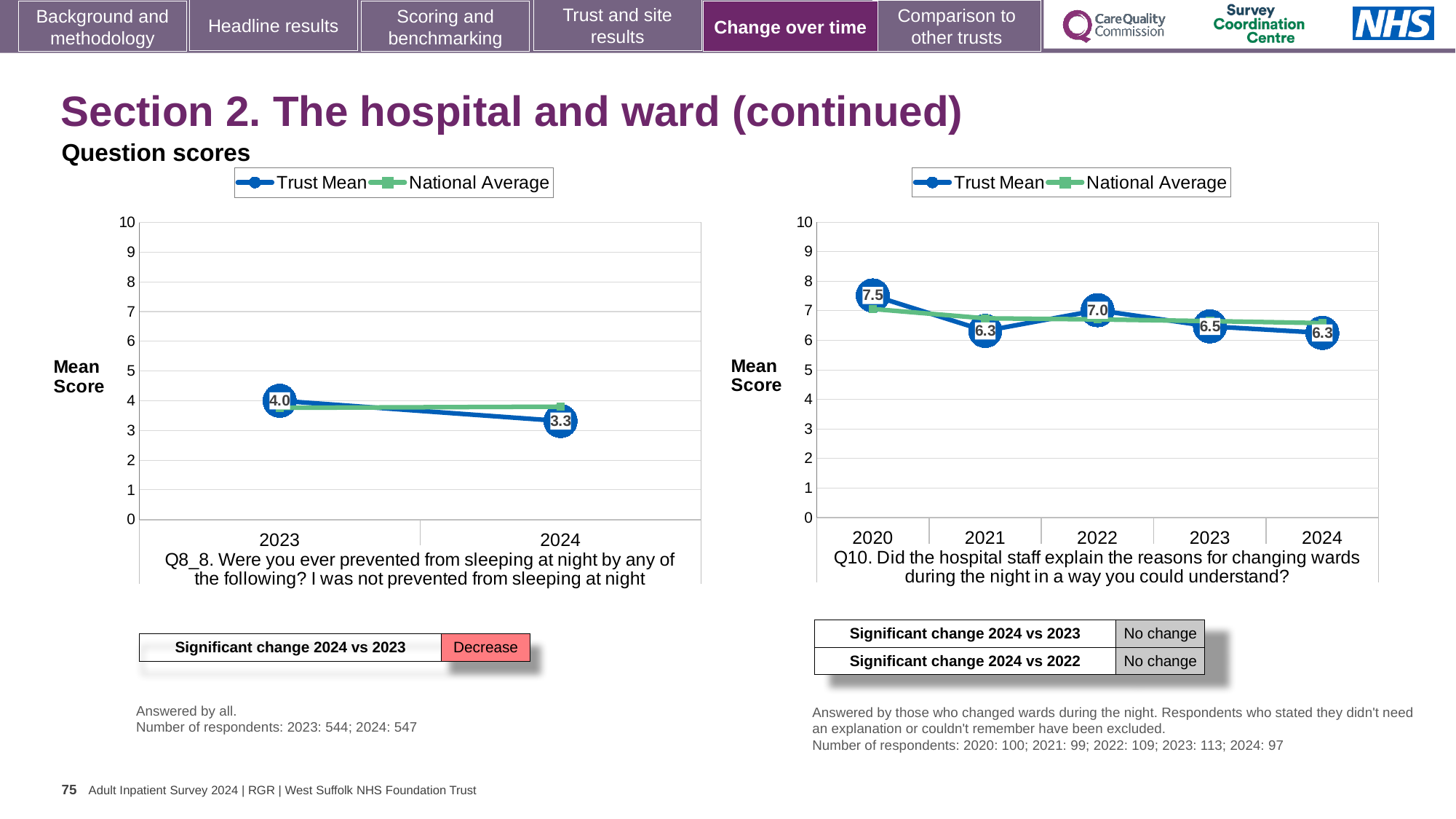
In the left chart (Q8_8), what is the Trust Mean score for 2024? 3.3 In the left chart (Q8_8), what is the Trust Mean score for 2023? 4.0 What type of chart is used for the left chart (Q8_8)? line chart In the left chart (Q8_8), by how much did the Trust Mean fall from 2023 to 2024? 0.7 In the left chart (Q8_8), does the Trust Mean rise or fall from 2023 to 2024? fall In the right chart (Q10), which year has the highest Trust Mean score? 2020 In the right chart (Q10), what is the Trust Mean score for 2022? 7.0 In the right chart (Q10), is the National Average for 2020 greater or less than 6? greater In the right chart (Q10), what is the difference between the Trust Mean scores for 2020 and 2024? 1.2 In the right chart (Q10), is the Trust Mean score for 2022 higher or lower than for 2023? higher In the right chart (Q10), what is the Trust Mean score for 2020? 7.5 How many years are plotted on the x axis of the right chart (Q10)? 5